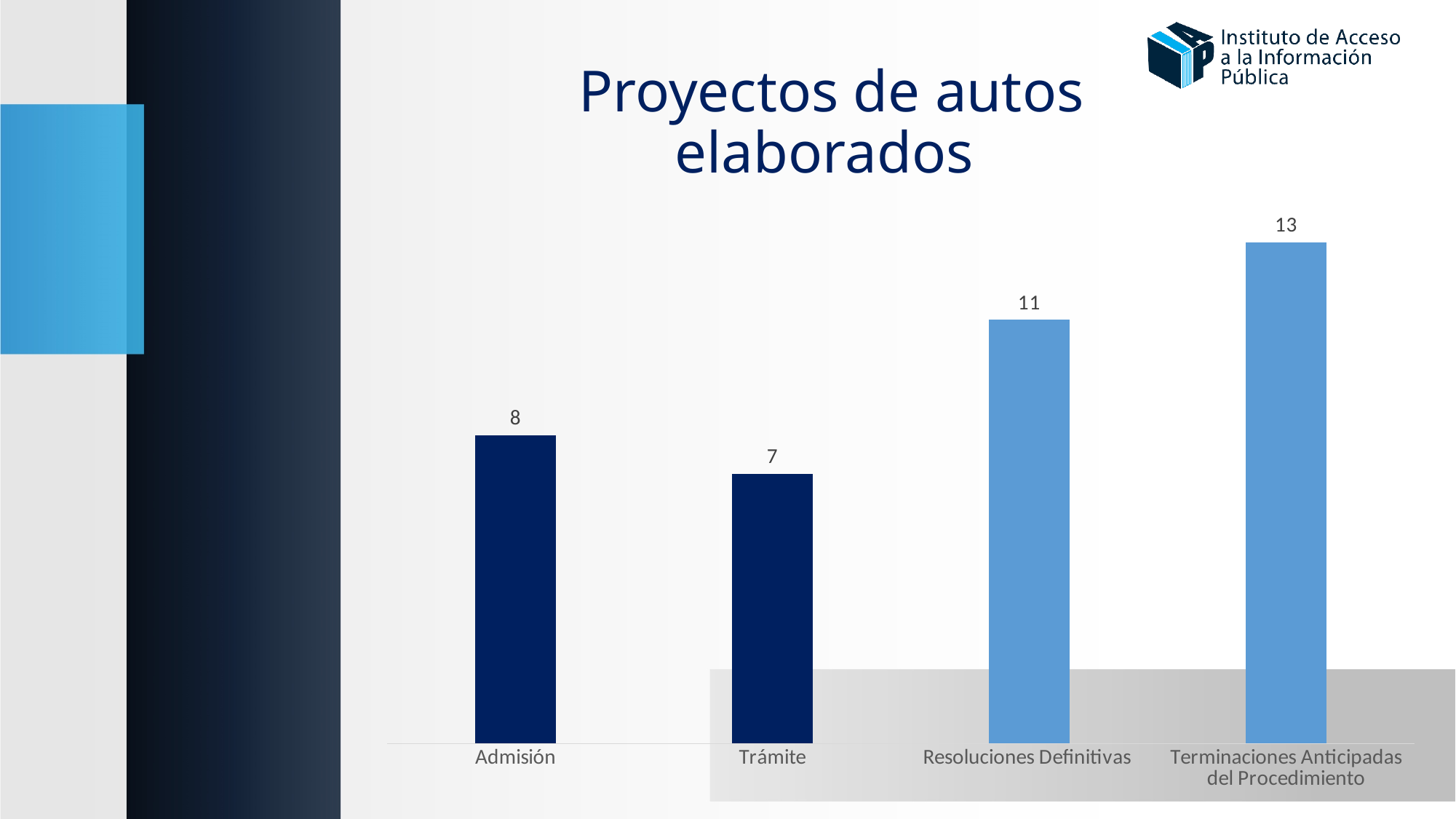
What is the title of the chart? Proyectos de autos elaborados Which category has the highest value? Terminaciones Anticipadas del Procedimiento What is the value for Terminaciones Anticipadas del Procedimiento? 13 What kind of chart is shown on the slide? Bar chart What is the value for Admisión? 8 How many categories are shown in the chart? 4 What is the value for Trámite? 7 What is the difference between the values for Resoluciones Definitivas and Trámite? 4 What is the difference between the values for Terminaciones Anticipadas del Procedimiento and Admisión? 5 What is the value for Resoluciones Definitivas? 11 Which is larger, the value for Admisión or the value for Resoluciones Definitivas? Resoluciones Definitivas Which category has the lowest value? Trámite